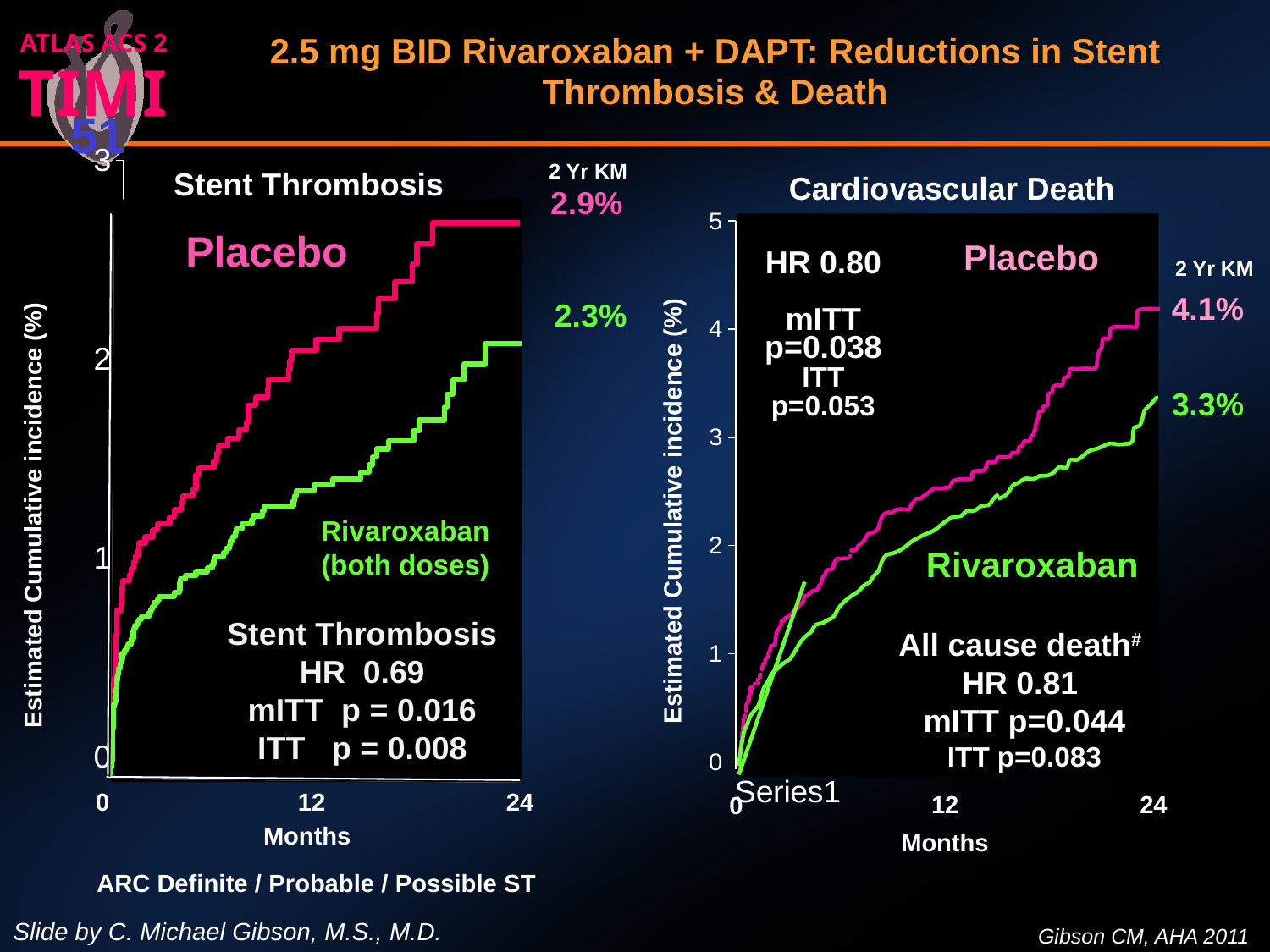
In the Stent Thrombosis chart, what is the difference between the 2-year KM estimates for Placebo and Rivaroxaban? 0.6% In the Stent Thrombosis chart, does the cumulative incidence for Placebo rise or fall over the months? Rise In the Cardiovascular Death chart, what is the difference between the 2-year KM estimates for Placebo and Rivaroxaban? 0.8% In the Cardiovascular Death chart, what is the 2-year KM estimate for Placebo? 4.1% What is the hazard ratio shown for Stent Thrombosis? 0.69 In the Cardiovascular Death chart, is the Placebo curve at 24 months greater or less than 4? greater In the Cardiovascular Death chart, which group has the higher 2-year KM estimate, Placebo or Rivaroxaban? Placebo In the Stent Thrombosis chart, what is the 2-year KM estimate for Placebo? 2.9% What kind of chart is the Cardiovascular Death chart? Line chart In the Stent Thrombosis chart, what is the 2-year KM estimate for Rivaroxaban (both doses)? 2.3% In the Stent Thrombosis chart, which group has the lower cumulative incidence at 24 months? Rivaroxaban (both doses) In the Cardiovascular Death chart, what is the 2-year KM estimate for Rivaroxaban? 3.3%